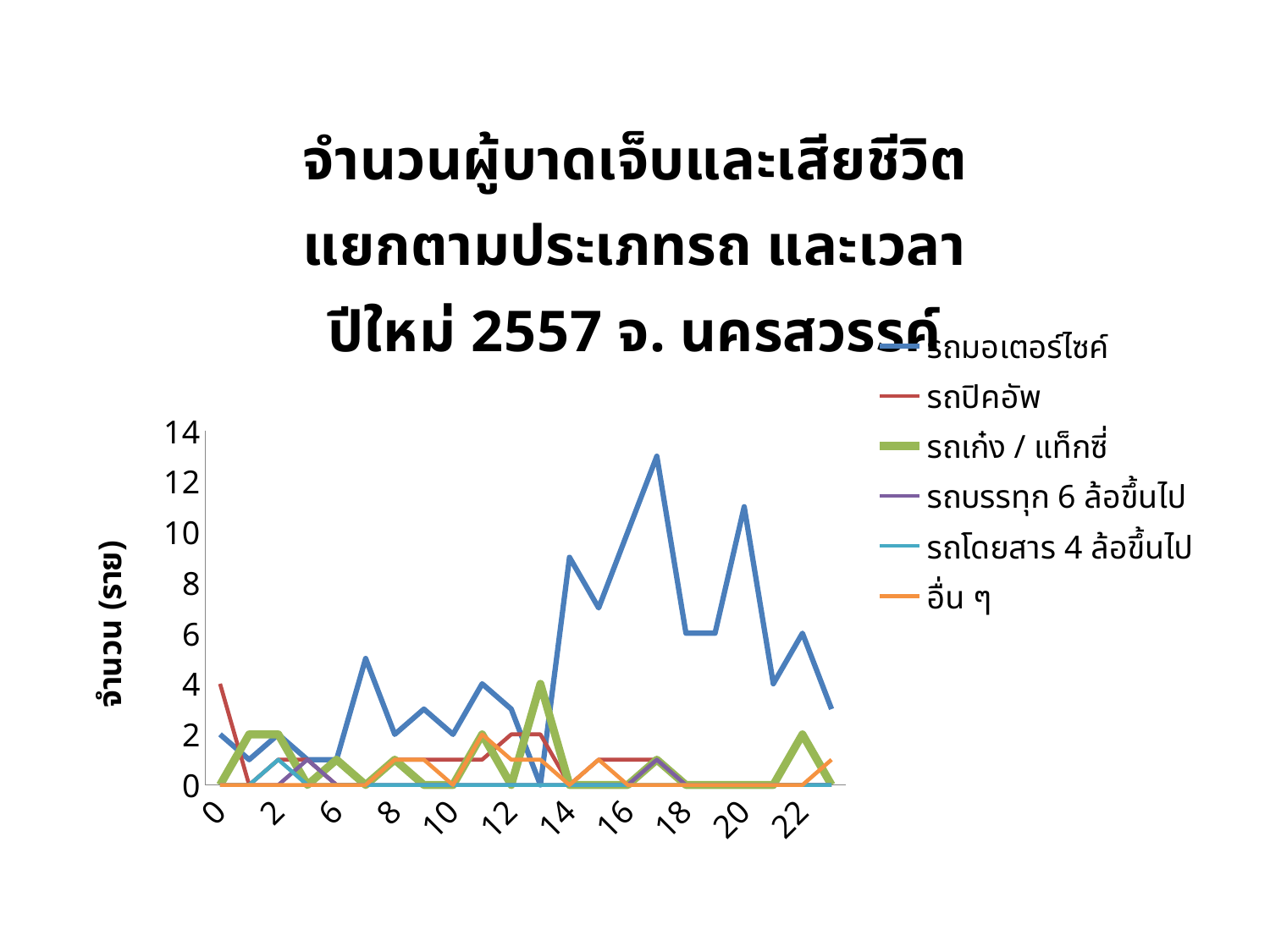
At which hour does the รถมอเตอร์ไซค์ line reach its peak? 17 Is the value for รถมอเตอร์ไซค์ at hour 7 greater or less than 4? greater Does the รถมอเตอร์ไซค์ line rise or fall between hour 13 and hour 17? rise What is the value for รถปิคอัพ at hour 0? 4 What is the label on the vertical axis? จำนวน (ราย) What is the value for รถเก๋ง / แท็กซี่ at hour 13? 4 Which series reaches the highest value on the chart? รถมอเตอร์ไซค์ What kind of chart is shown on the slide? line chart Which is larger at hour 17: the value for รถมอเตอร์ไซค์ or the value for รถปิคอัพ? รถมอเตอร์ไซค์ How many series does the legend list? 6 Is the value for รถมอเตอร์ไซค์ at hour 17 greater or less than 12? greater Is the value for รถมอเตอร์ไซค์ at hour 20 greater or less than 10? greater